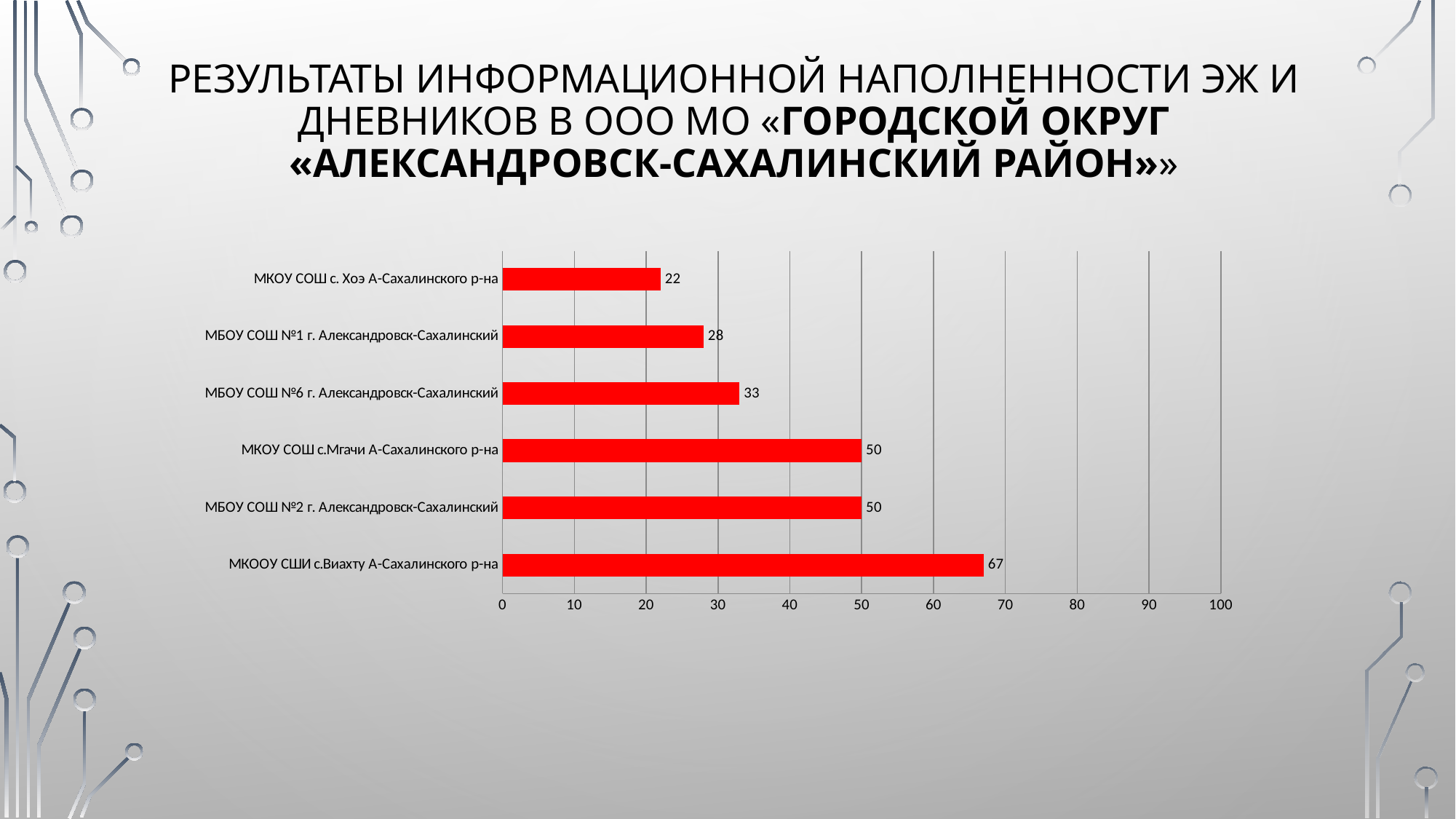
How many categories are shown in the chart? 6 What is the difference between the values for МКООУ СШИ с.Виахту А-Сахалинского р-на and МБОУ СОШ №2 г. Александровск-Сахалинский? 17 What is the value for МКООУ СШИ с.Виахту А-Сахалинского р-на? 67 Is the value for МКООУ СШИ с.Виахту А-Сахалинского р-на greater or less than 60? greater Which category has the highest value? МКООУ СШИ с.Виахту А-Сахалинского р-на What is the value for МБОУ СОШ №6 г. Александровск-Сахалинский? 33 What is the difference between the values for МБОУ СОШ №6 г. Александровск-Сахалинский and МБОУ СОШ №1 г. Александровск-Сахалинский? 5 What kind of chart is shown on the slide? bar chart Which category has the lowest value? МКОУ СОШ с. Хоэ А-Сахалинского р-на What is the value for МБОУ СОШ №1 г. Александровск-Сахалинский? 28 What is the value for МКОУ СОШ с. Хоэ А-Сахалинского р-на? 22 Which is larger, the value for МКОУ СОШ с.Мгачи А-Сахалинского р-на or the value for МБОУ СОШ №6 г. Александровск-Сахалинский? МКОУ СОШ с.Мгачи А-Сахалинского р-на